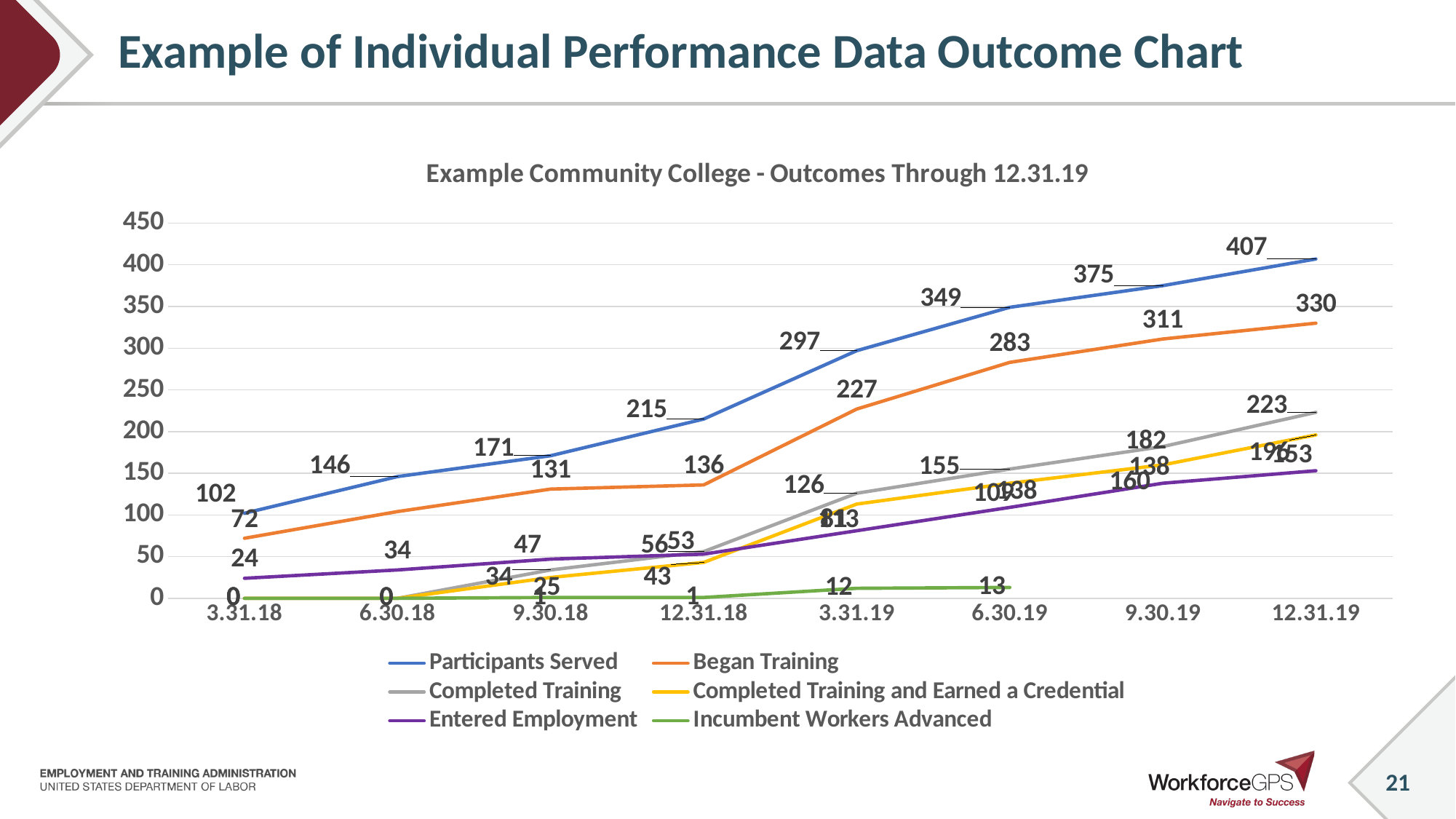
What is the value for Participants Served at 12.31.19? 407 Is the value for Began Training at 6.30.18 greater or less than 150? less How many dates are plotted along the x axis? 8 What is the value for Completed Training at 12.31.19? 223 What is the value for Incumbent Workers Advanced at 6.30.19? 13 Does the Participants Served line rise or fall from 3.31.18 to 12.31.19? rise What is the difference between Participants Served at 12.31.19 and at 9.30.19? 32 What is the value for Began Training at 3.31.19? 227 At which date is Participants Served highest? 12.31.19 How many series does the legend list? 6 At 6.30.19, which is larger: Began Training or Completed Training? Began Training What kind of chart is shown on the slide? line chart